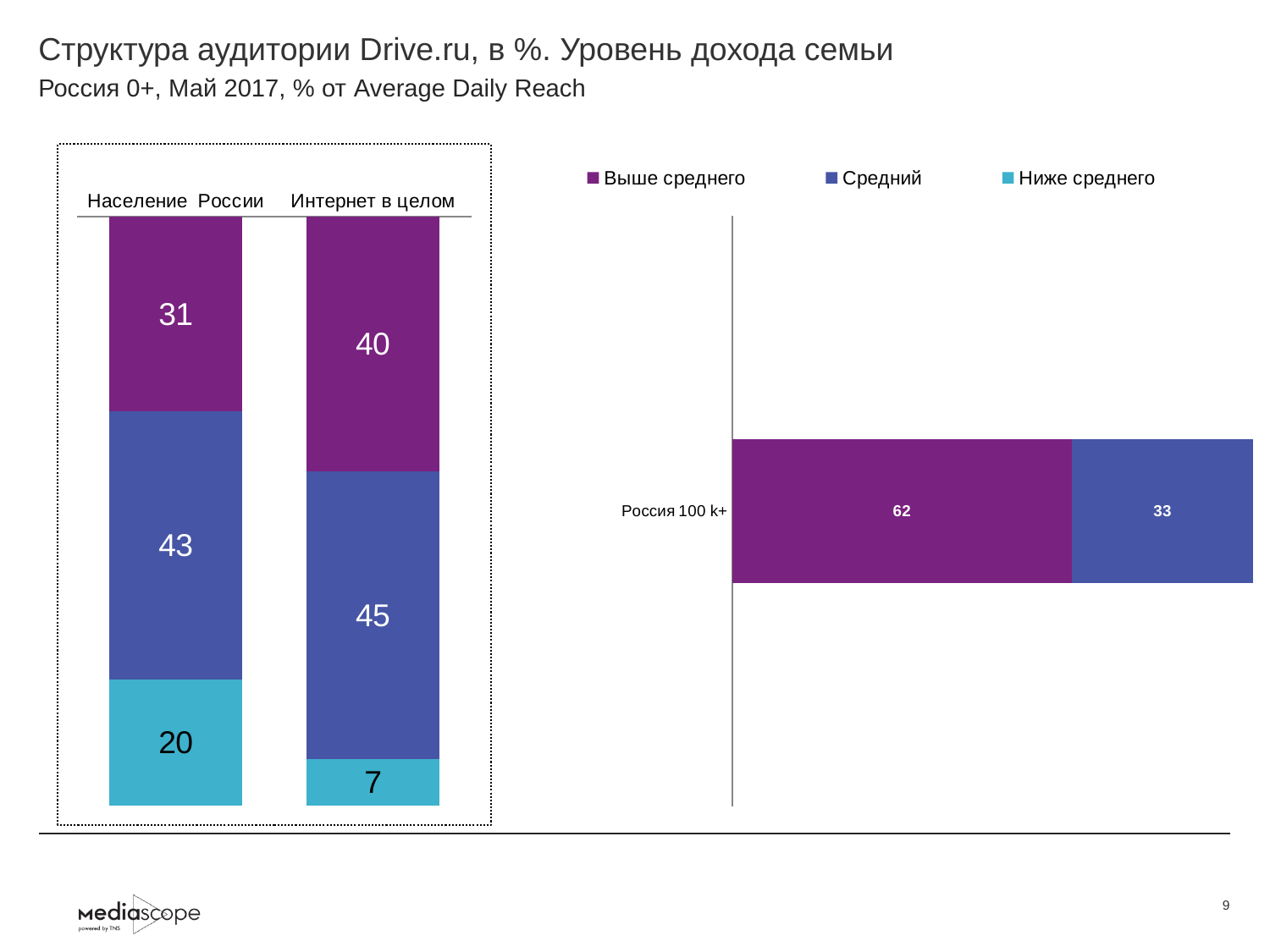
How many series does the legend list? 3 In the right chart, what is the value of the 'Средний' segment for 'Россия 100 k+'? 33 In the left chart, what is the value of the 'Ниже среднего' segment for 'Население России'? 20 In the left chart, what is the value of the 'Средний' segment for 'Интернет в целом'? 45 In the left chart, what is the value of the 'Ниже среднего' segment for 'Интернет в целом'? 7 In the left chart, what is the difference between the 'Выше среднего' values for 'Интернет в целом' and 'Население России'? 9 What kind of chart is the right chart? Stacked bar chart In the left chart, what is the value of the 'Выше среднего' segment for 'Население России'? 31 In the right chart, what is the value of the 'Выше среднего' segment for 'Россия 100 k+'? 62 In the left chart, how many categories are shown on the x axis? 2 In the left chart, what is the total of the stacked bar for 'Население России'? 94 In the left chart, which category has the larger 'Ниже среднего' segment, 'Население России' or 'Интернет в целом'? Население России